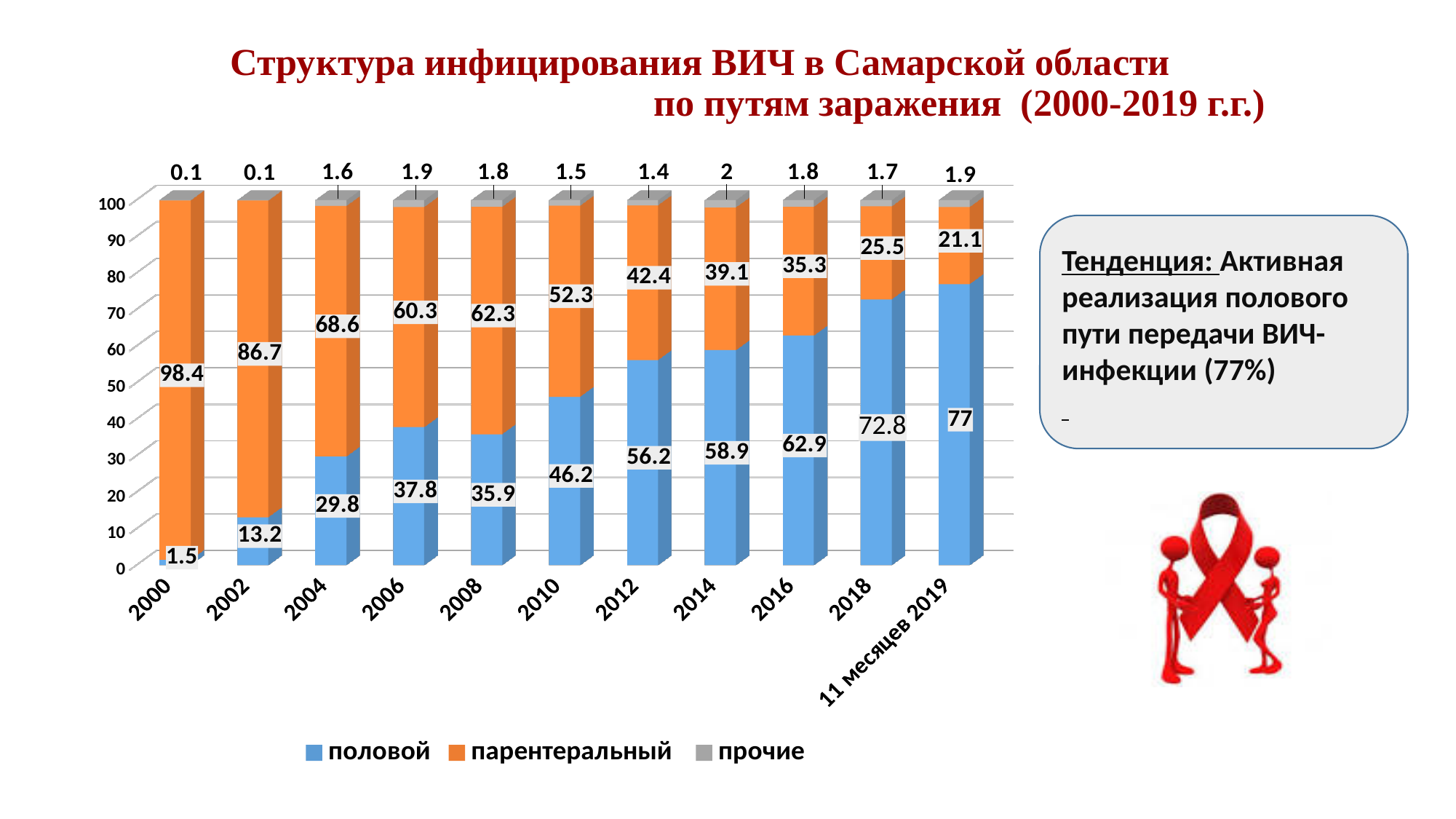
What is the value of the парентеральный series for 2004? 68.6 How many categories are shown on the x axis? 11 What is the value of the половой series for 2010? 46.2 What kind of chart is shown on the slide? stacked bar chart Does the половой series rise or fall from 2000 to 11 месяцев 2019? rise What is the value of the половой series for 11 месяцев 2019? 77 How many series does the legend list? 3 What is the value of the прочие series for 2014? 2 Which is larger for 2012: the половой value or the парентеральный value? половой Which category has the highest value for the половой series? 11 месяцев 2019 What is the difference between the половой and парентеральный values for 2018? 47.3 Which category has the lowest value for the парентеральный series? 11 месяцев 2019